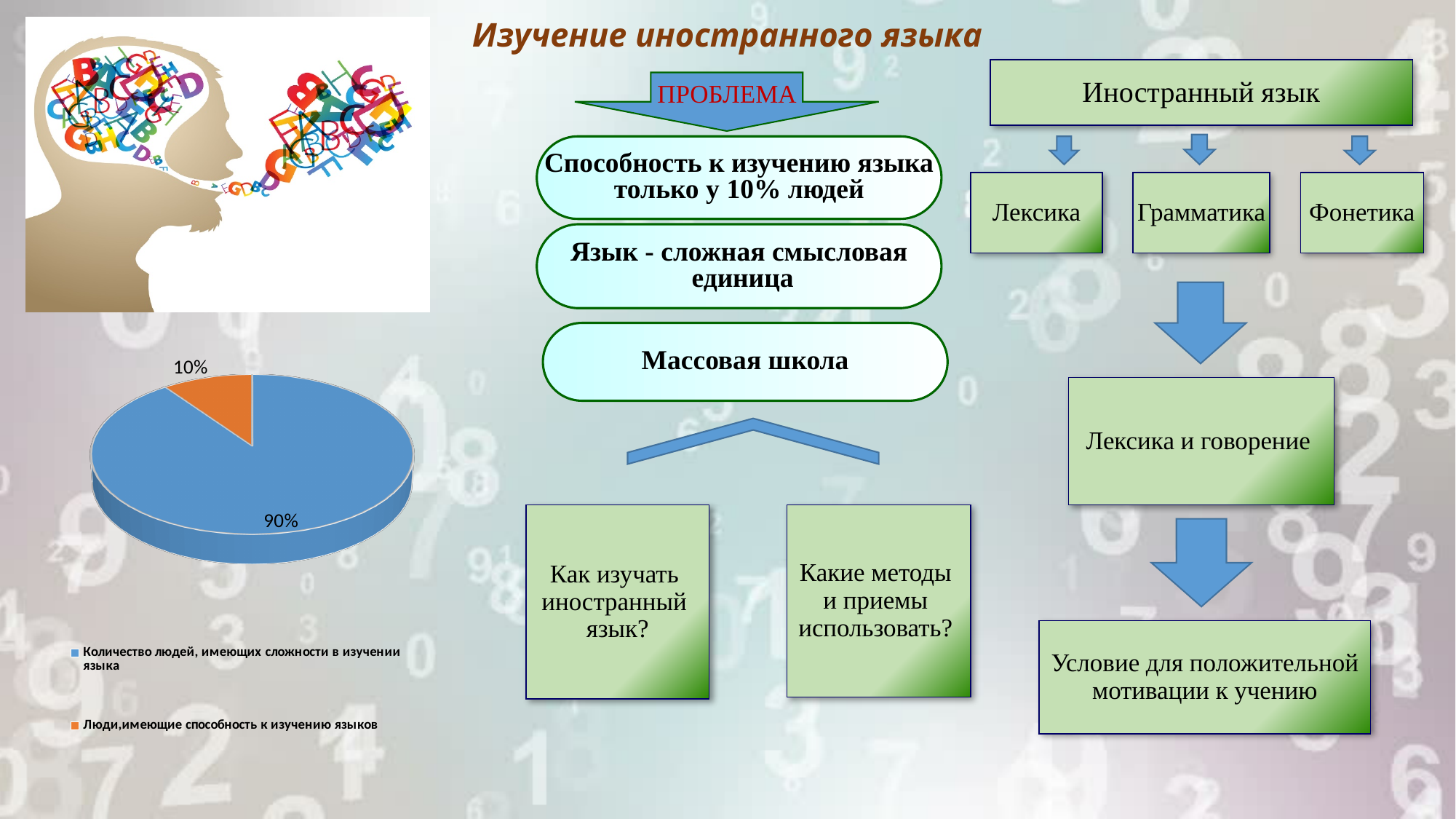
What kind of chart is shown on the slide? pie chart What share of the pie does "Люди,имеющие способность к изучению языков" take? 10% How many entries does the legend of the pie chart list? 2 How many slices does the pie chart have? 2 Which is larger: the slice for people having difficulties learning a language or the slice for people having the ability to learn languages? people having difficulties learning a language Which slice of the pie chart is the smallest? Люди,имеющие способность к изучению языков What is the difference in percentage points between the two slices of the pie chart? 80 Which slice of the pie chart is the largest? Количество людей, имеющих сложности в изучении языка What colour is the slice for "Люди,имеющие способность к изучению языков"? orange What share of the pie does "Количество людей, имеющих сложности в изучении языка" take? 90% What is the total of the two slice percentages shown on the pie chart? 100% What colour is the slice for "Количество людей, имеющих сложности в изучении языка"? blue